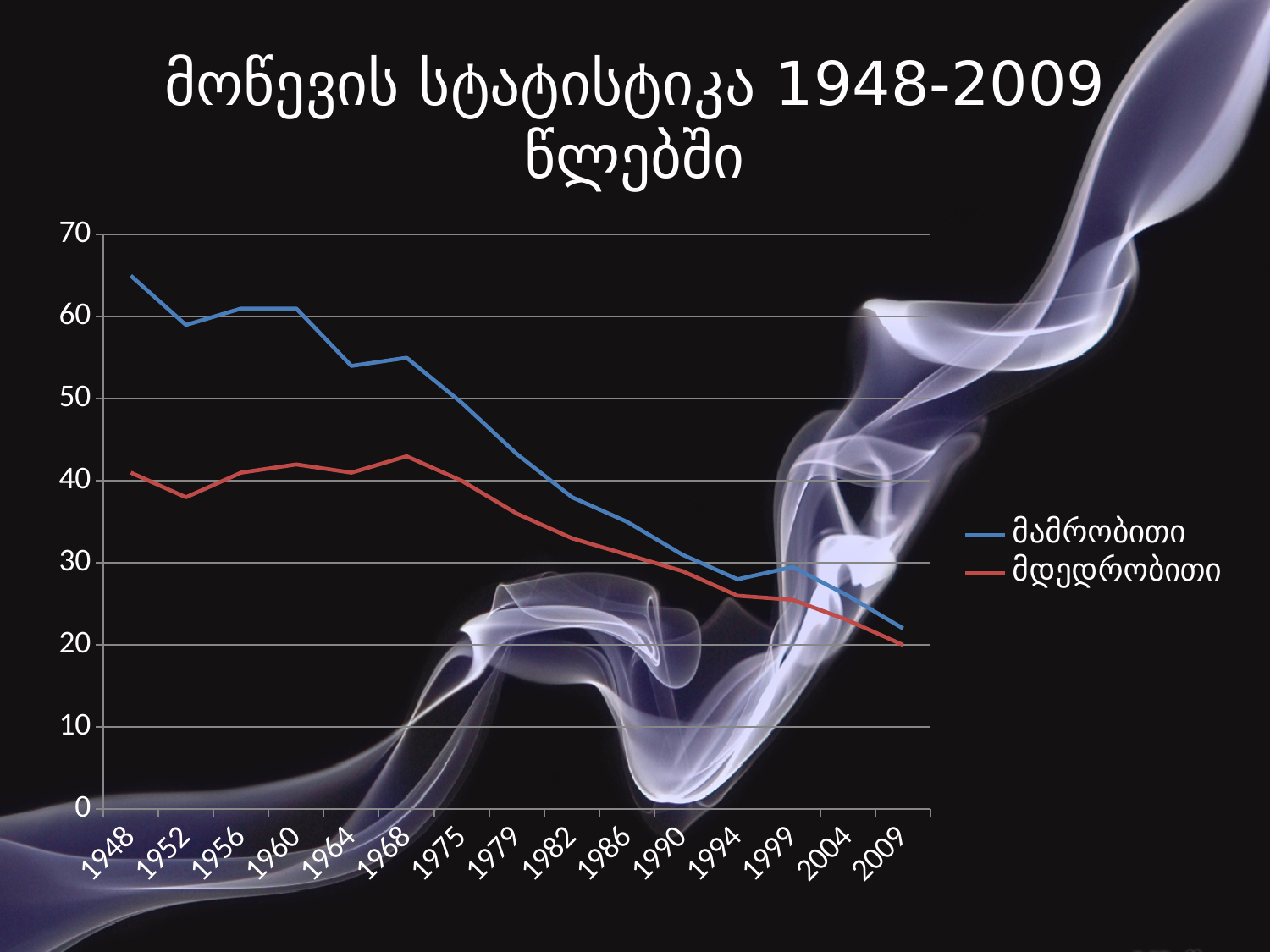
Is the value for მამრობითი in 1964 greater or less than 50? greater How many years are labelled on the x axis? 15 Is the value for მამრობითი in 1948 greater or less than 60? greater Is the value for მდედრობითი in 1994 greater or less than 30? less What kind of chart is shown on the slide? line chart In which year is the მამრობითი series at its highest? 1948 In 1948, which series has the higher value, მამრობითი or მდედრობითი? მამრობითი How many series does the legend list? 2 Which series is drawn in blue? მამრობითი Does the მდედრობითი series generally rise or fall from 1948 to 2009? fall In which year is the მამრობითი series at its lowest? 2009